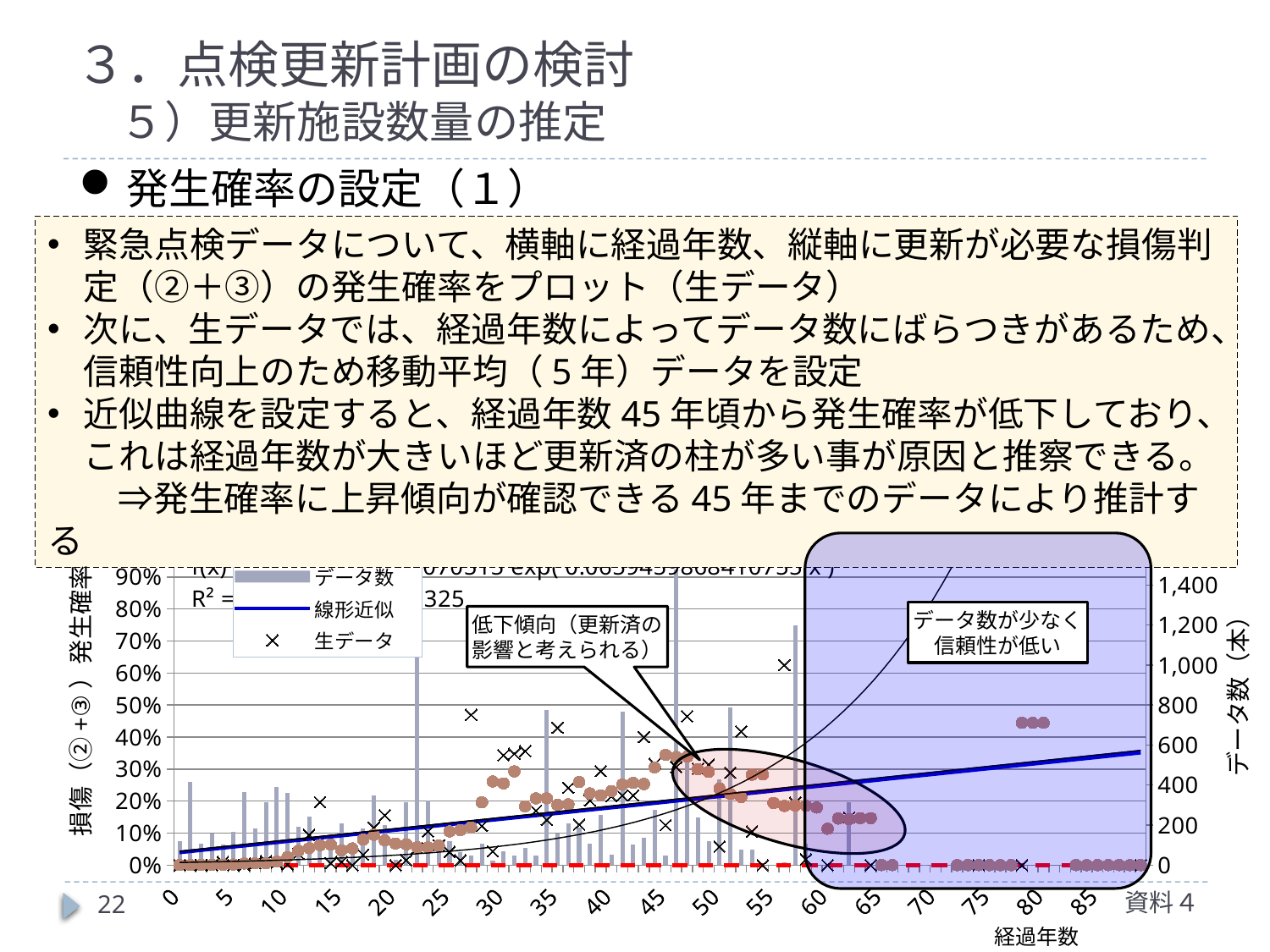
What is the maximum value shown on the right-hand vertical axis? 1,400 What is the maximum value shown on the left-hand vertical axis? 90% What kind of chart is shown on the slide? A combination chart with bars and line/scatter series How many tick labels are shown on the horizontal axis (from 0 to 85 in steps of 5)? 18 Is the highest 生データ point near 経過年数 57 greater or less than 50%? greater Does the 線形近似 line rise or fall as 経過年数 increases? Rises What is the title of the horizontal axis of the chart? 経過年数 What is the title of the right-hand vertical axis of the chart? データ数（本） Are the moving-average dots near 経過年数 80 greater or less than 40%? greater Which is higher: the moving-average dots near 経過年数 80 or those near 経過年数 85? Near 経過年数 80 Is the value of the 線形近似 line at 経過年数 0 greater or less than 10%? less